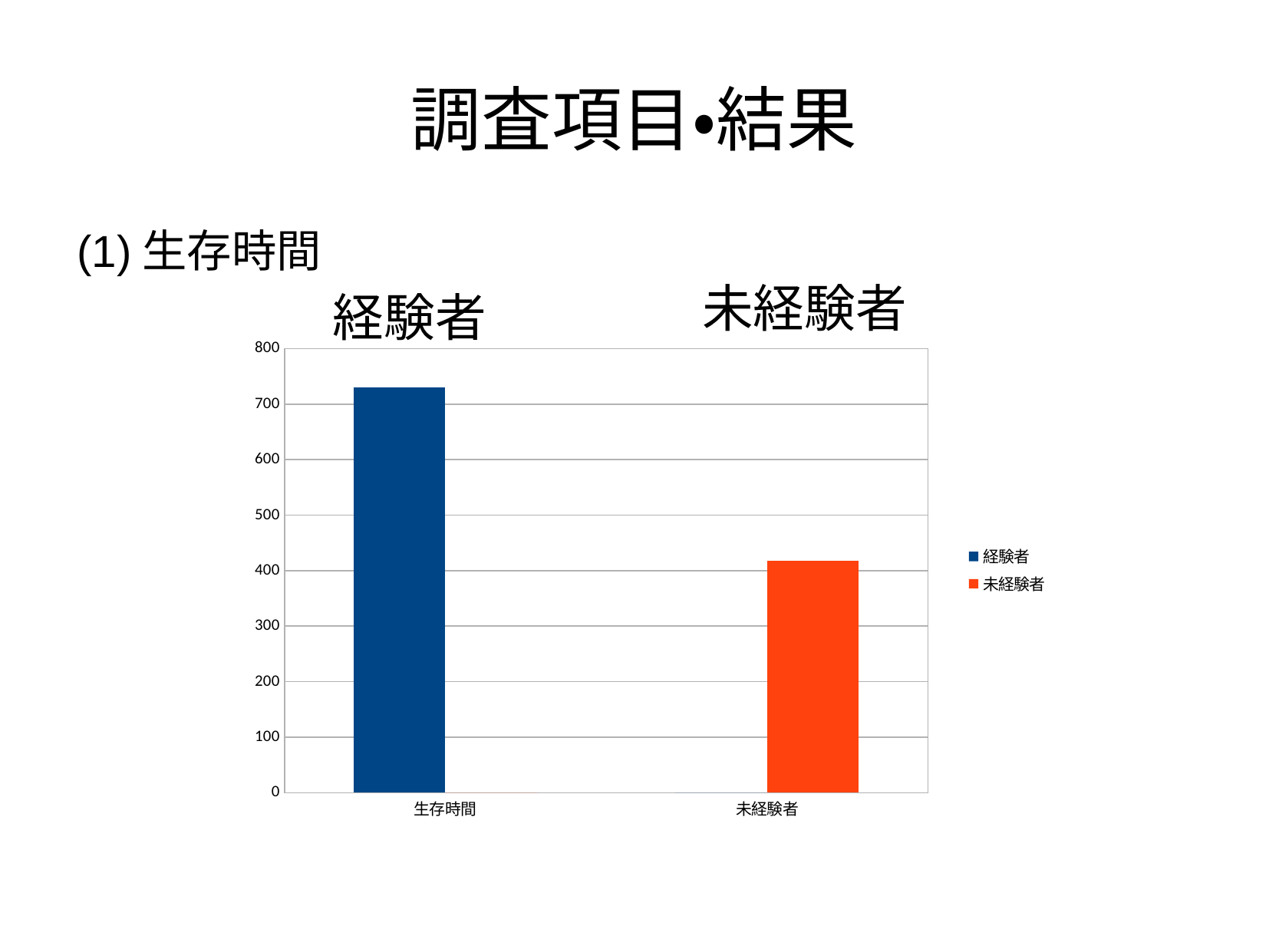
How many bars are plotted in the chart? 2 What is the maximum value shown on the vertical axis? 800 Which group has the highest value in the chart? 経験者 How many series does the legend list? 2 Is the value for 経験者 greater or less than 700? greater Which group has the higher bar, 経験者 or 未経験者? 経験者 Is the value for 未経験者 greater or less than 400? greater Which group has the lowest value in the chart? 未経験者 Is the value for 経験者 greater or less than 800? less What colour is the bar for 未経験者? orange What kind of chart is shown on the slide? bar chart